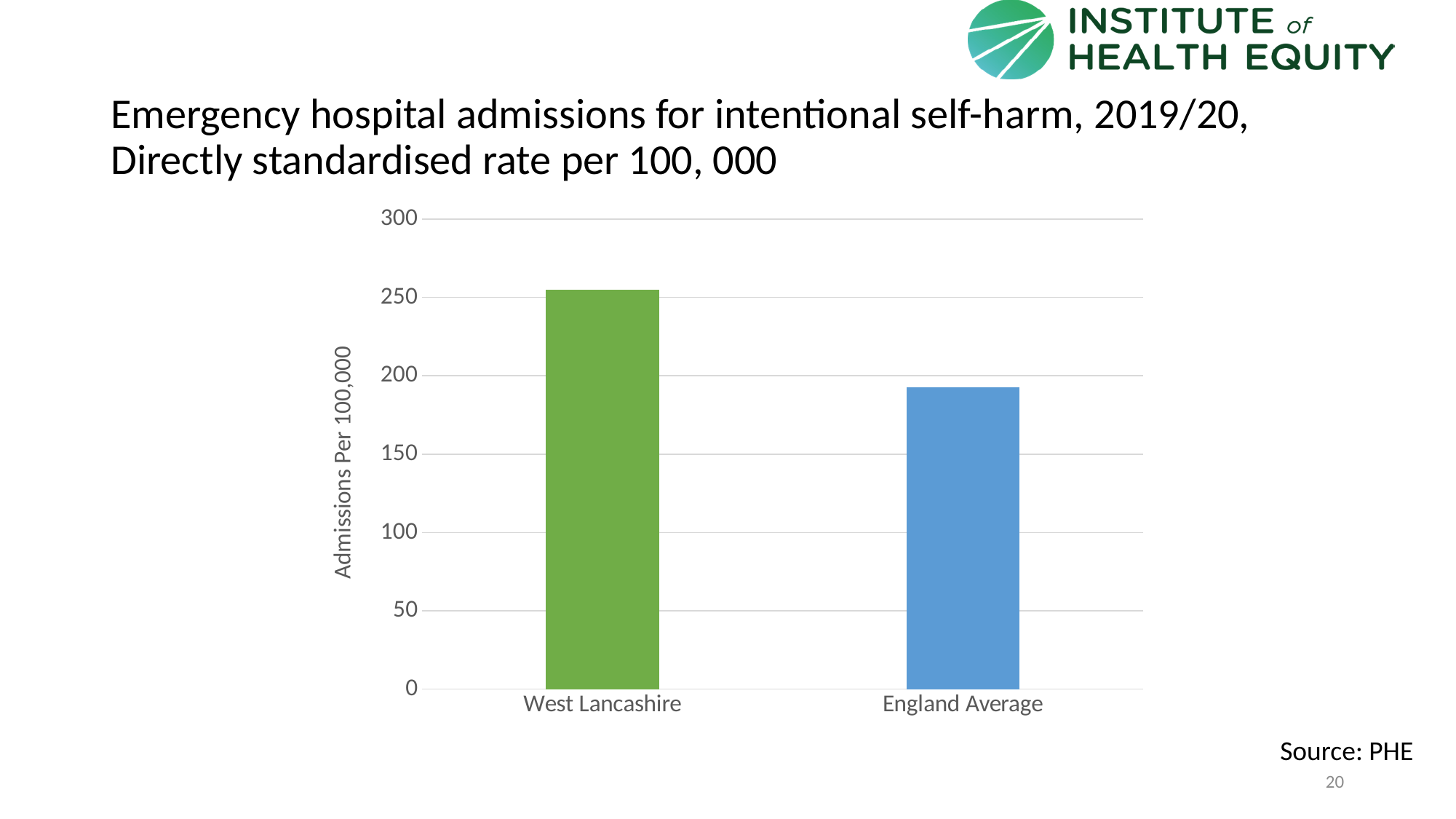
Is the value for West Lancashire greater or less than 300? less What kind of chart is shown on the slide? bar chart Is the value for West Lancashire greater or less than 250? greater Which is larger, the value for West Lancashire or the value for England Average? West Lancashire Which category has the highest value? West Lancashire Is the value for England Average greater or less than 200? less What colour is the bar for West Lancashire? green What is the label on the vertical axis of the chart? Admissions Per 100,000 Which category has the lowest value? England Average How many categories are plotted on the chart? 2